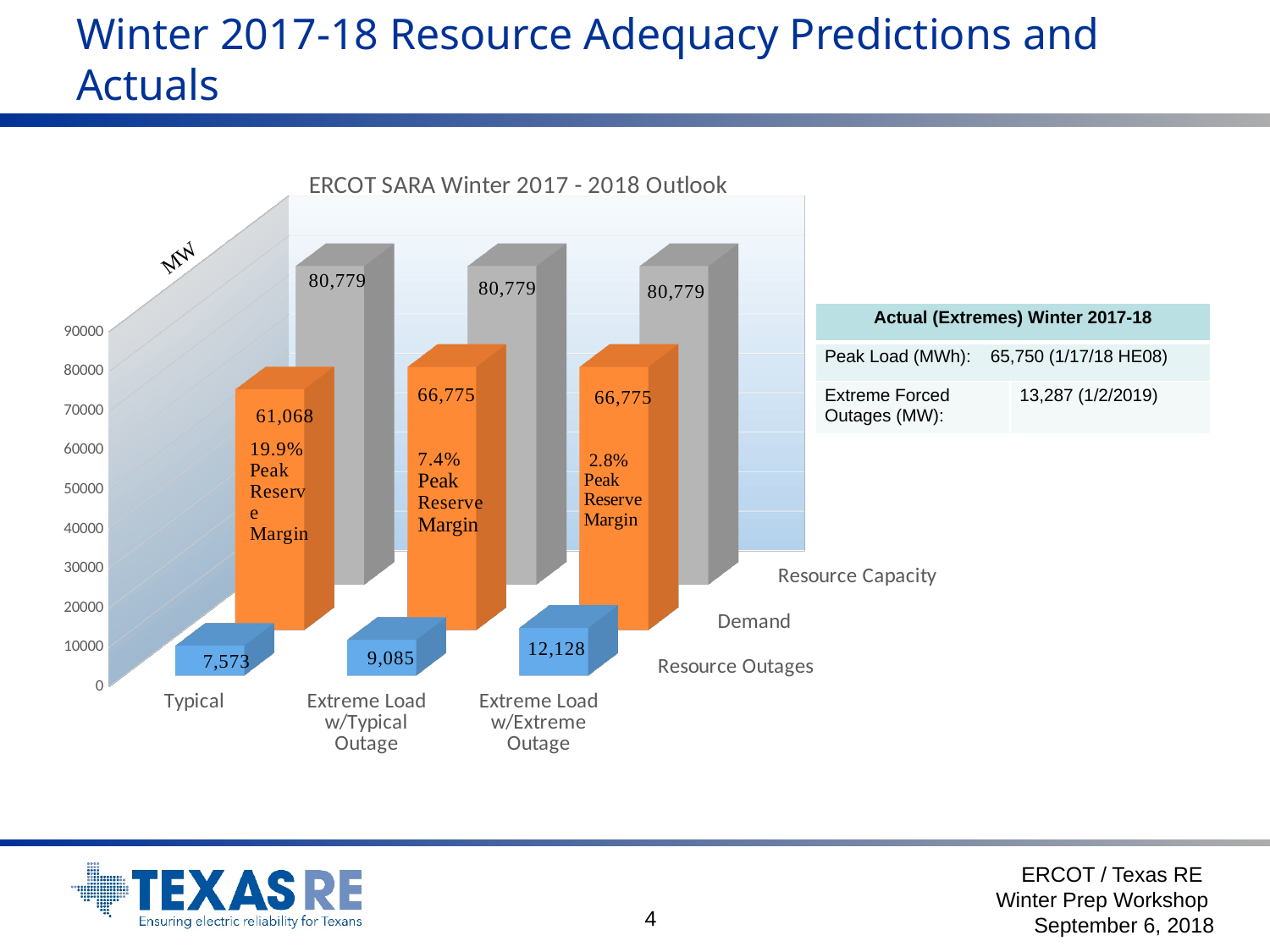
What is the difference between the Demand values for the Extreme Load w/Typical Outage and Typical scenarios? 5,707 How many categories are shown along the x axis of the chart? 3 How many series does the chart show? 3 What type of chart is shown on the slide? bar chart What is the title of the chart on the slide? ERCOT SARA Winter 2017 - 2018 Outlook Which scenario has the lowest Resource Outages value? Typical What is the Resource Capacity value for the Typical scenario? 80,779 What is the Resource Outages value for the Extreme Load w/Extreme Outage scenario? 12,128 What is the Demand value for the Extreme Load w/Typical Outage scenario? 66,775 What peak reserve margin is labelled for the Extreme Load w/Extreme Outage scenario? 2.8% Which scenario has the highest Resource Outages value? Extreme Load w/Extreme Outage Is the Demand value for the Typical scenario larger or smaller than the Demand value for the Extreme Load w/Extreme Outage scenario? smaller